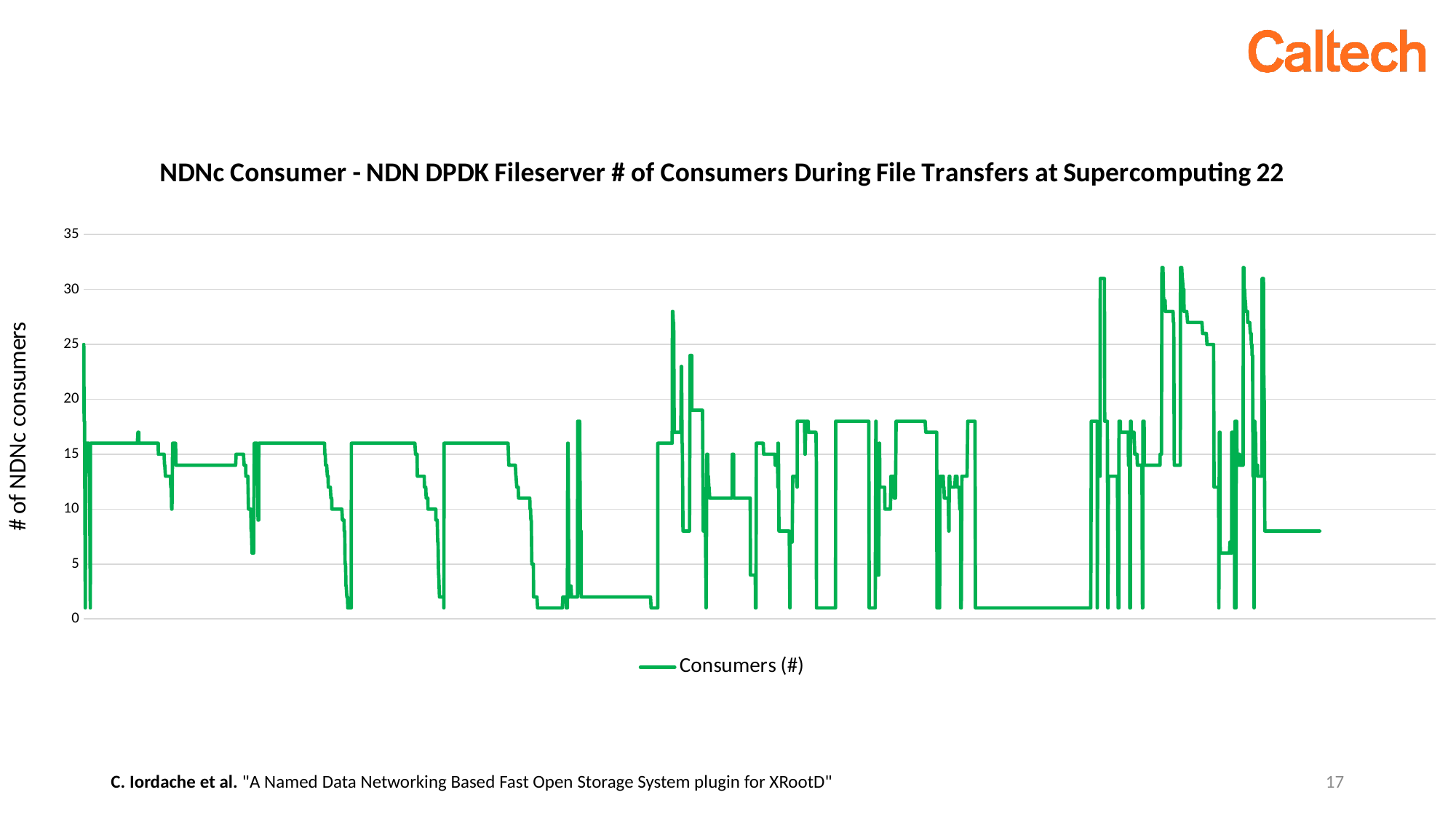
What is the label of the series shown in the legend? Consumers (#) How many series does the legend list? 1 Is the highest value reached by the Consumers (#) line greater or less than 30? greater Is the highest value reached by the Consumers (#) line greater or less than 35? less Is the lowest value reached by the Consumers (#) line greater or less than 5? less What is the title of the chart? NDNc Consumer - NDN DPDK Fileserver # of Consumers During File Transfers at Supercomputing 22 What kind of chart is shown on the slide? line chart